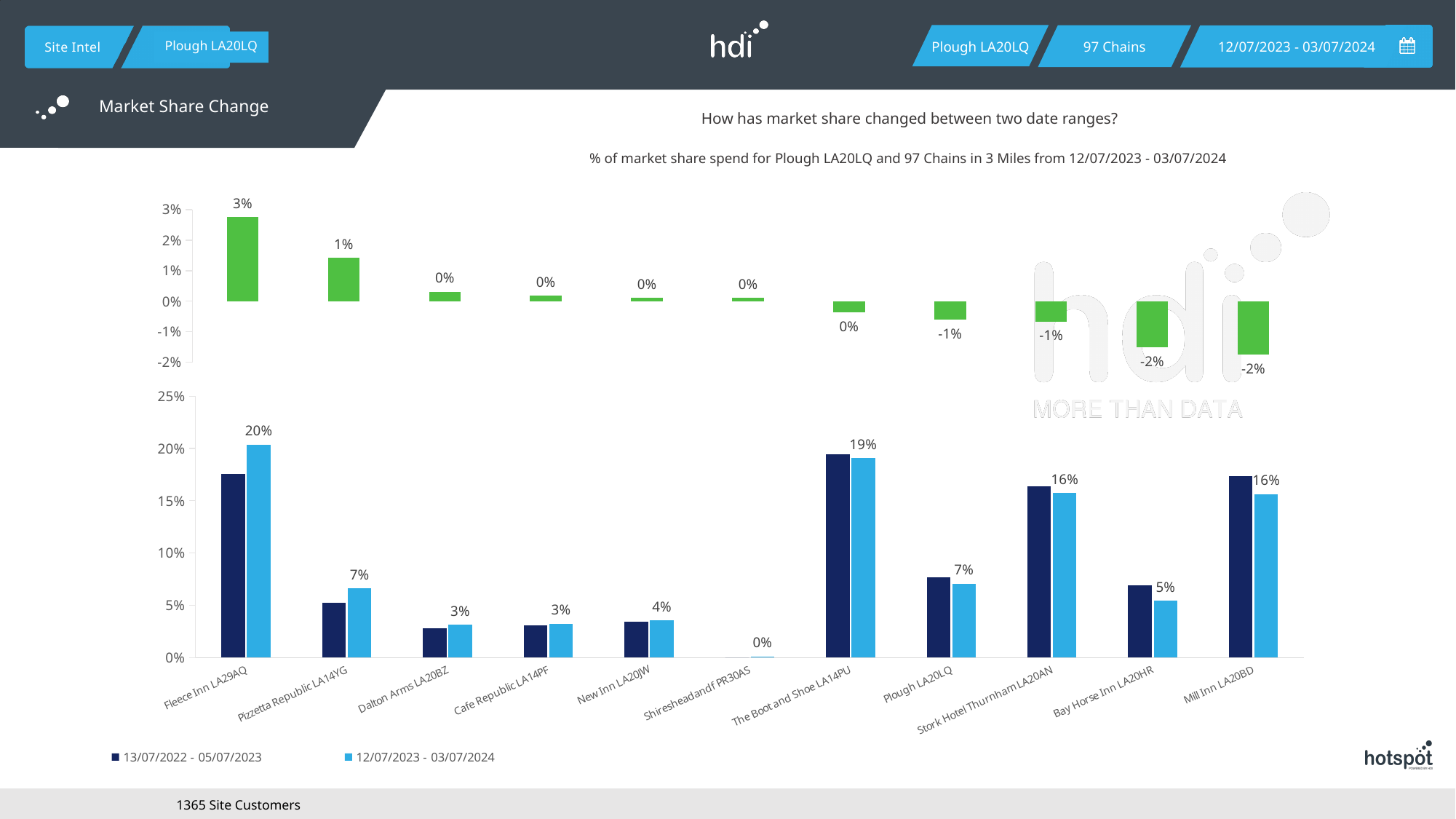
In the bottom chart, what is the 12/07/2023 - 03/07/2024 market share for The Boot and Shoe LA14PU? 19% In the bottom chart, what is the difference between the 12/07/2023 - 03/07/2024 market share of Fleece Inn LA29AQ and Pizzetta Republic LA14YG? 13 percentage points In the top chart (market share change), what is the value shown for Mill Inn LA20BD? -2% In the top chart (market share change), how many venues are plotted? 11 In the top chart (market share change), which venue has the highest change? Fleece Inn LA29AQ In the bottom chart, which venue has the highest 12/07/2023 - 03/07/2024 market share? Fleece Inn LA29AQ What kind of chart is the bottom chart? Bar chart In the bottom chart, which has the larger 12/07/2023 - 03/07/2024 market share: Plough LA20LQ or Bay Horse Inn LA20HR? Plough LA20LQ How many series does the legend of the bottom chart list? 2 What are the two date ranges listed in the legend of the bottom chart? 13/07/2022 - 05/07/2023 and 12/07/2023 - 03/07/2024 In the bottom chart, is the 13/07/2022 - 05/07/2023 value for Fleece Inn LA29AQ greater or less than 15%? greater In the top chart (market share change), what is the value shown for Fleece Inn LA29AQ? 3%